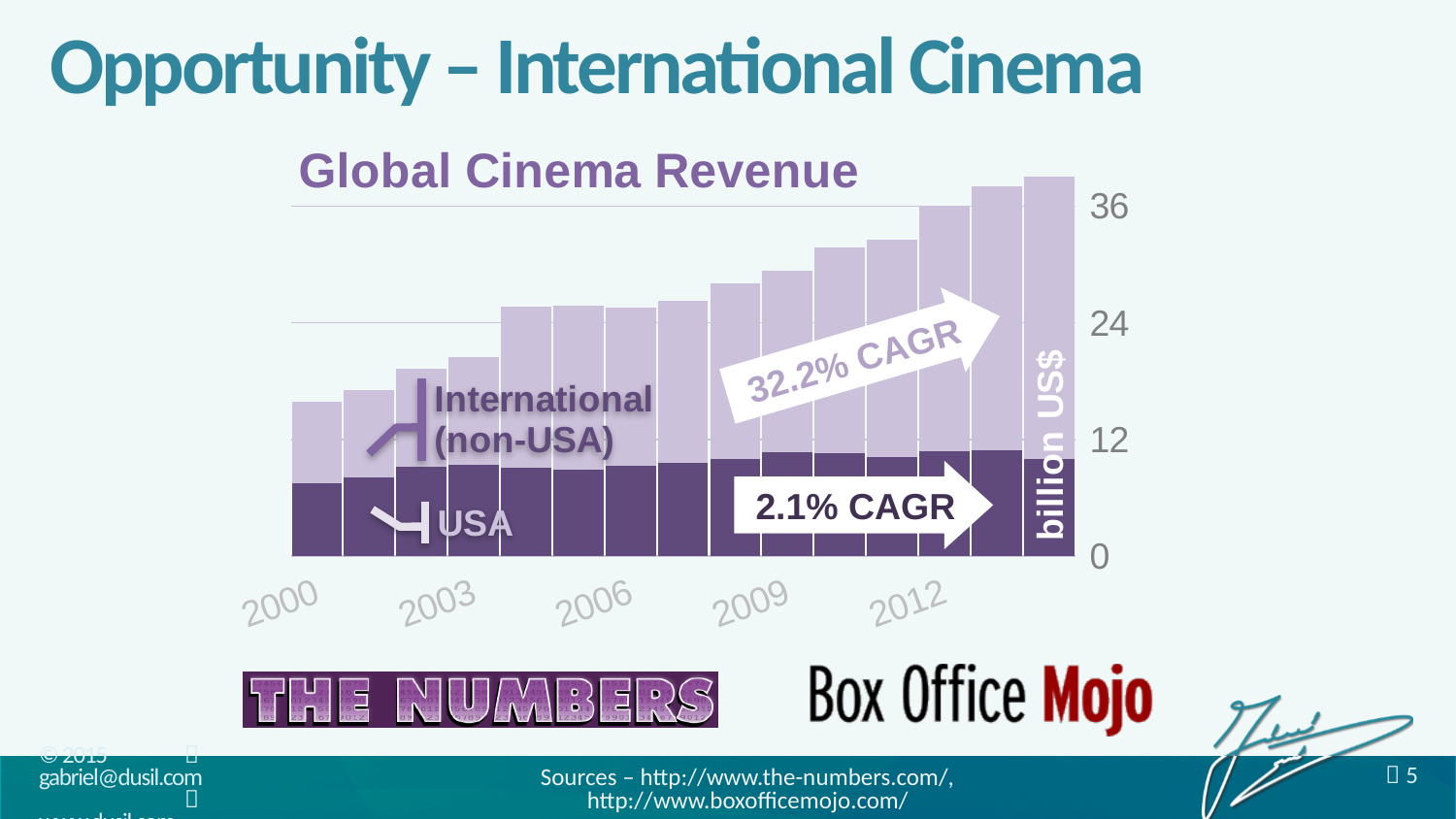
How many series does the chart show? 2 In 2012, which series is larger, USA or International (non-USA)? International (non-USA) Is the USA revenue for 2000 greater or less than 12? less What is the title of the chart? Global Cinema Revenue Is the total revenue for 2000 greater or less than 24? less Does total global cinema revenue rise or fall from 2000 to the last year shown? rise Is the total revenue for 2000 greater or less than 12? greater What unit is shown on the chart's vertical axis? billion US$ What type of chart is shown on the slide? stacked bar chart What CAGR is shown for USA revenue? 2.1% What CAGR is shown for International (non-USA) revenue? 32.2%